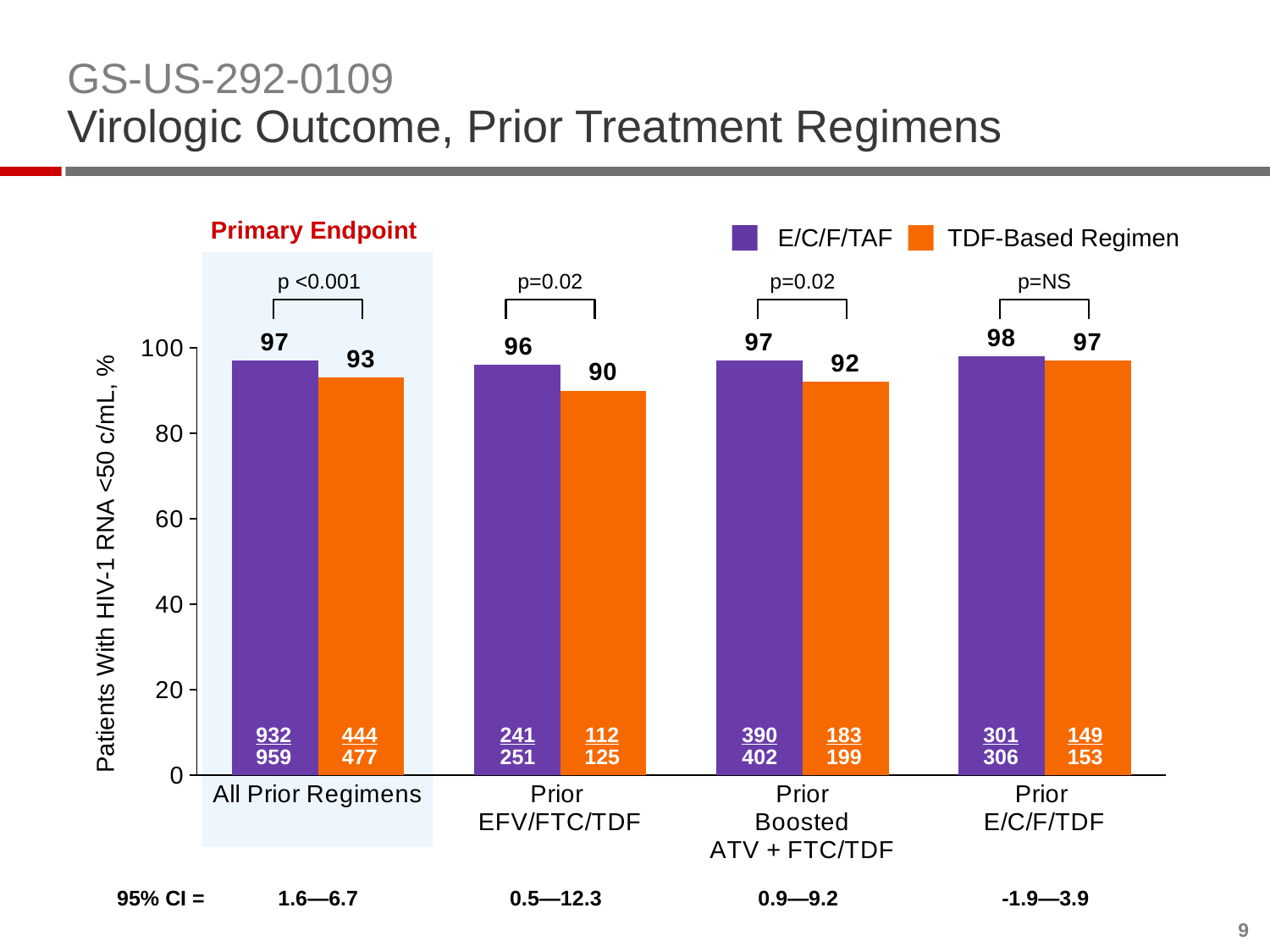
What is the value for E/C/F/TAF in the Prior E/C/F/TDF category? 98 What is the value for E/C/F/TAF in the All Prior Regimens category? 97 What kind of chart is shown on the slide? Bar chart What is the difference between the E/C/F/TAF and TDF-Based Regimen values in the All Prior Regimens category? 4 How many categories are shown on the x axis? 4 Which category has the highest value for the E/C/F/TAF series? Prior E/C/F/TDF What is the value for TDF-Based Regimen in the Prior Boosted ATV + FTC/TDF category? 92 In the Prior Boosted ATV + FTC/TDF category, which series has the larger value, E/C/F/TAF or TDF-Based Regimen? E/C/F/TAF What is the difference between the E/C/F/TAF and TDF-Based Regimen values in the Prior EFV/FTC/TDF category? 6 What is the value for TDF-Based Regimen in the Prior EFV/FTC/TDF category? 90 Which category has the lowest value for the TDF-Based Regimen series? Prior EFV/FTC/TDF How many series does the legend list? 2